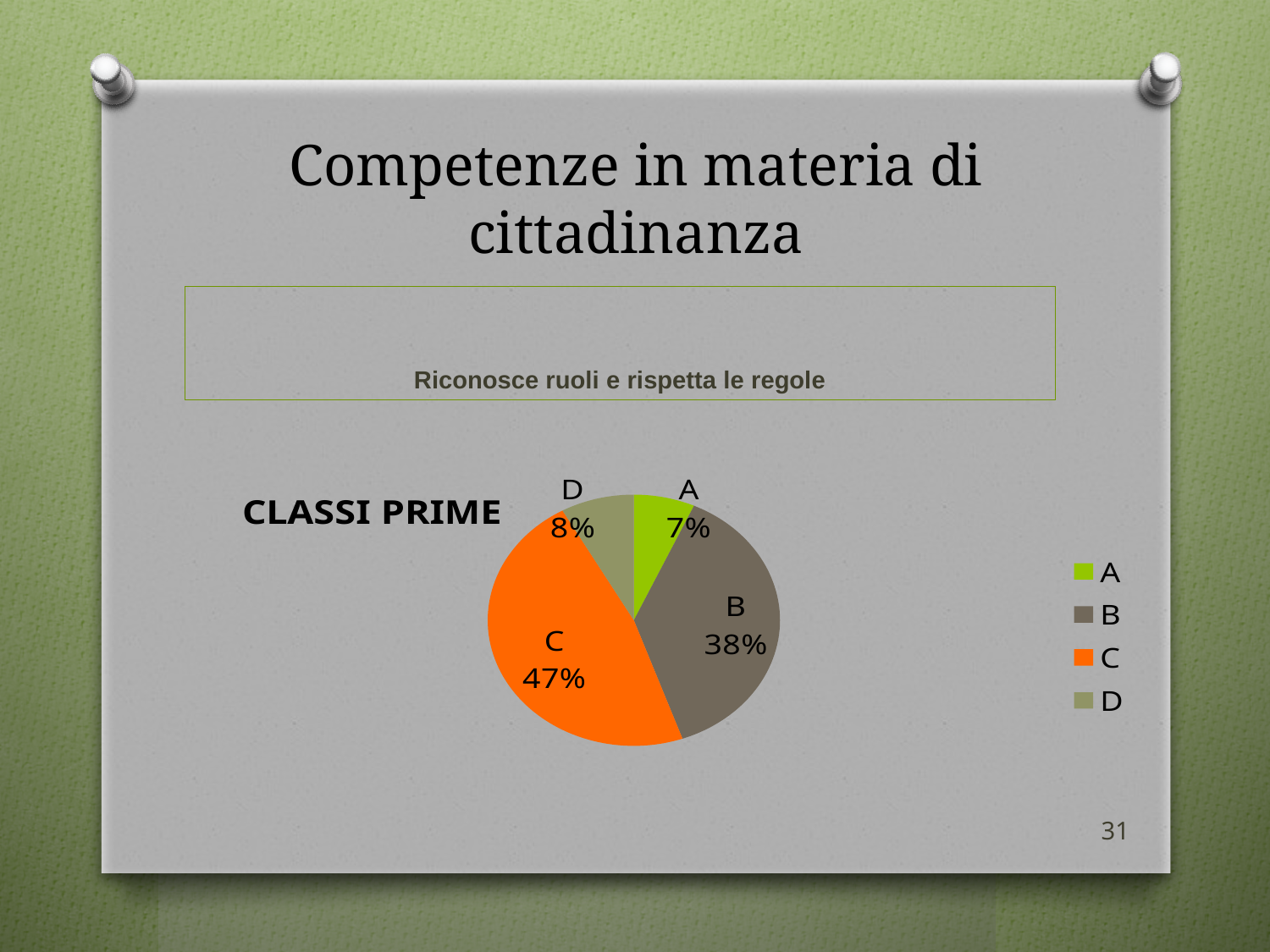
What is the title of the pie chart? CLASSI PRIME Which category has the largest slice of the pie chart? C Which category has the smallest slice of the pie chart? A What is the difference between the values for C and B? 9% What type of chart is shown on the slide? pie chart What is the value for category C in the pie chart? 47% What is the value for category B in the pie chart? 38% Which is larger, the value for B or the value for D? B What is the value for category A in the pie chart? 7% How many categories are shown in the pie chart? 4 What colour is the slice for category C? orange What is the value for category D in the pie chart? 8%